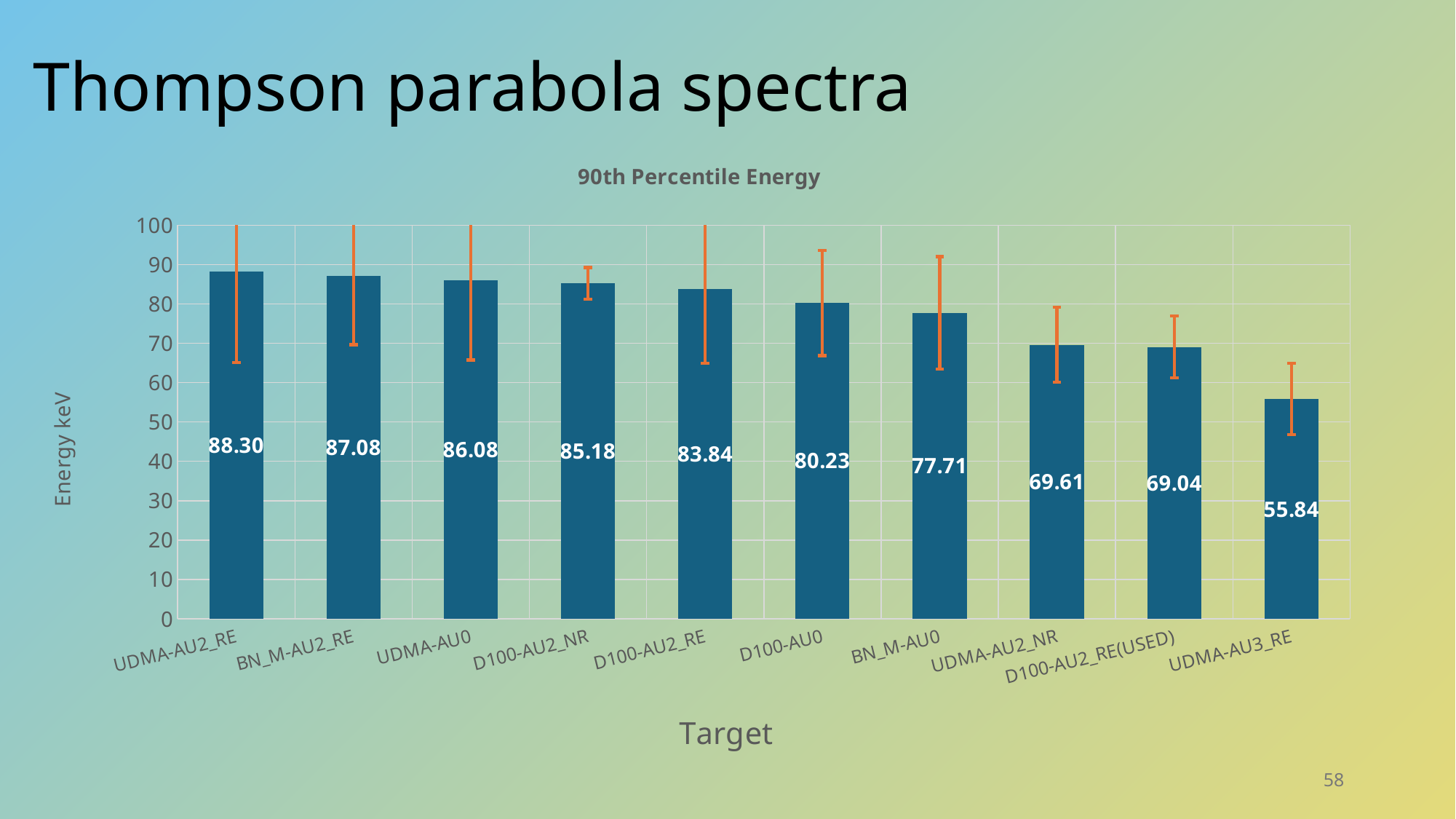
Which target has the highest 90th percentile energy? UDMA-AU2_RE What is the 90th percentile energy for UDMA-AU2_RE? 88.30 Which is larger, the value for D100-AU2_NR or the value for D100-AU2_RE? D100-AU2_NR What is the title of the chart? 90th Percentile Energy Which target has the lowest 90th percentile energy? UDMA-AU3_RE What is the value shown for D100-AU0? 80.23 What is the difference between the values for BN_M-AU2_RE and BN_M-AU0? 9.37 Is the value for UDMA-AU2_NR greater or less than 60? greater What kind of chart is shown on the slide? bar chart What is the value shown for D100-AU2_RE(USED)? 69.04 What is the difference between the values for UDMA-AU2_RE and UDMA-AU3_RE? 32.46 How many targets are shown on the x axis? 10